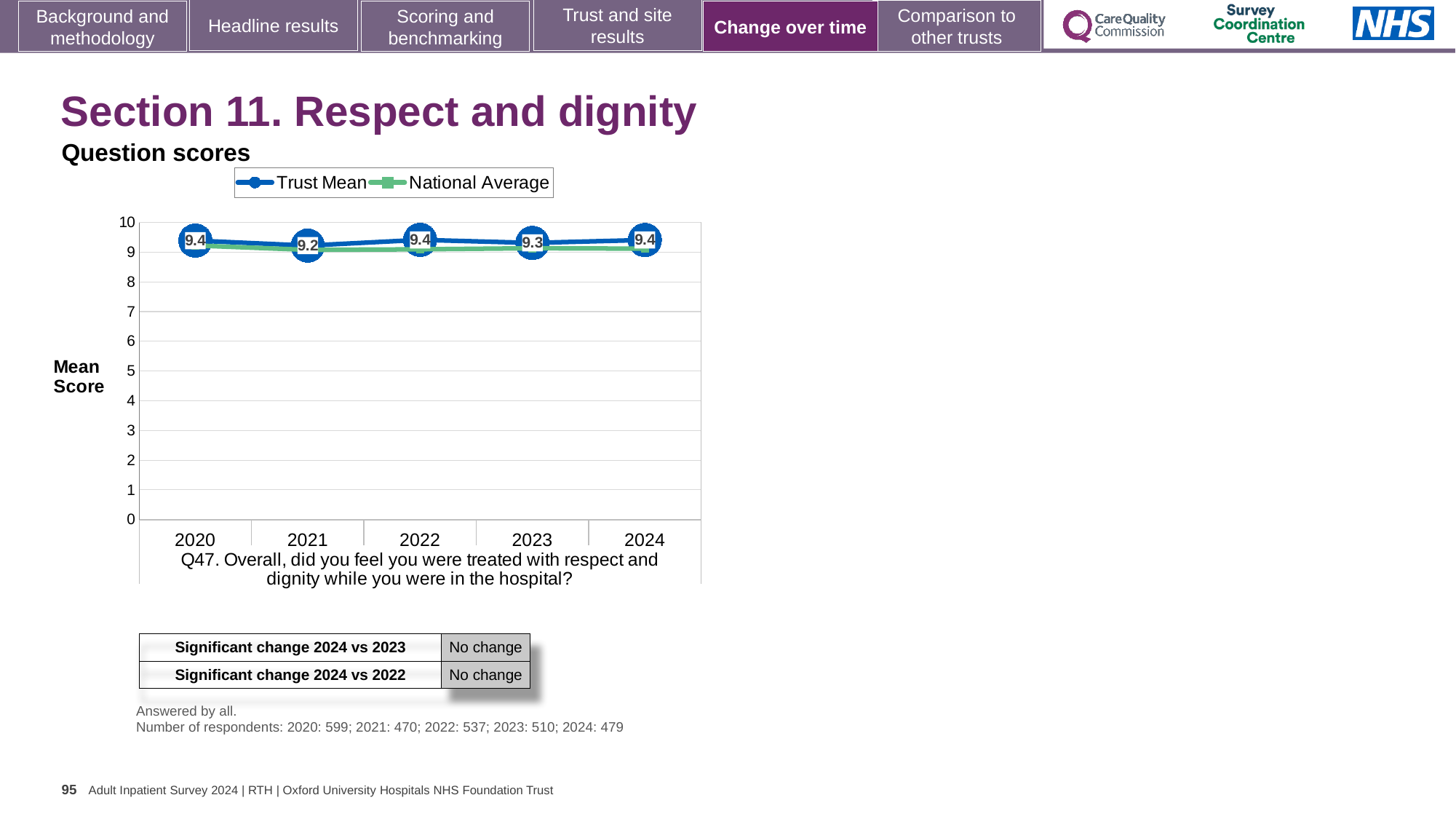
How many years are shown on the x axis? 5 In which year is the Trust Mean lowest? 2021 What is the Trust Mean value for 2020? 9.4 What is the difference between the Trust Mean in 2020 and in 2021? 0.2 What is the Trust Mean value for 2023? 9.3 Which is larger, the Trust Mean for 2021 or for 2023? 2023 What is the Trust Mean value for 2021? 9.2 What are the two series named in the legend? Trust Mean and National Average What is the Trust Mean value for 2024? 9.4 What kind of chart is shown? line chart Is the National Average value for 2020 greater or less than 8? greater How many series does the legend list? 2